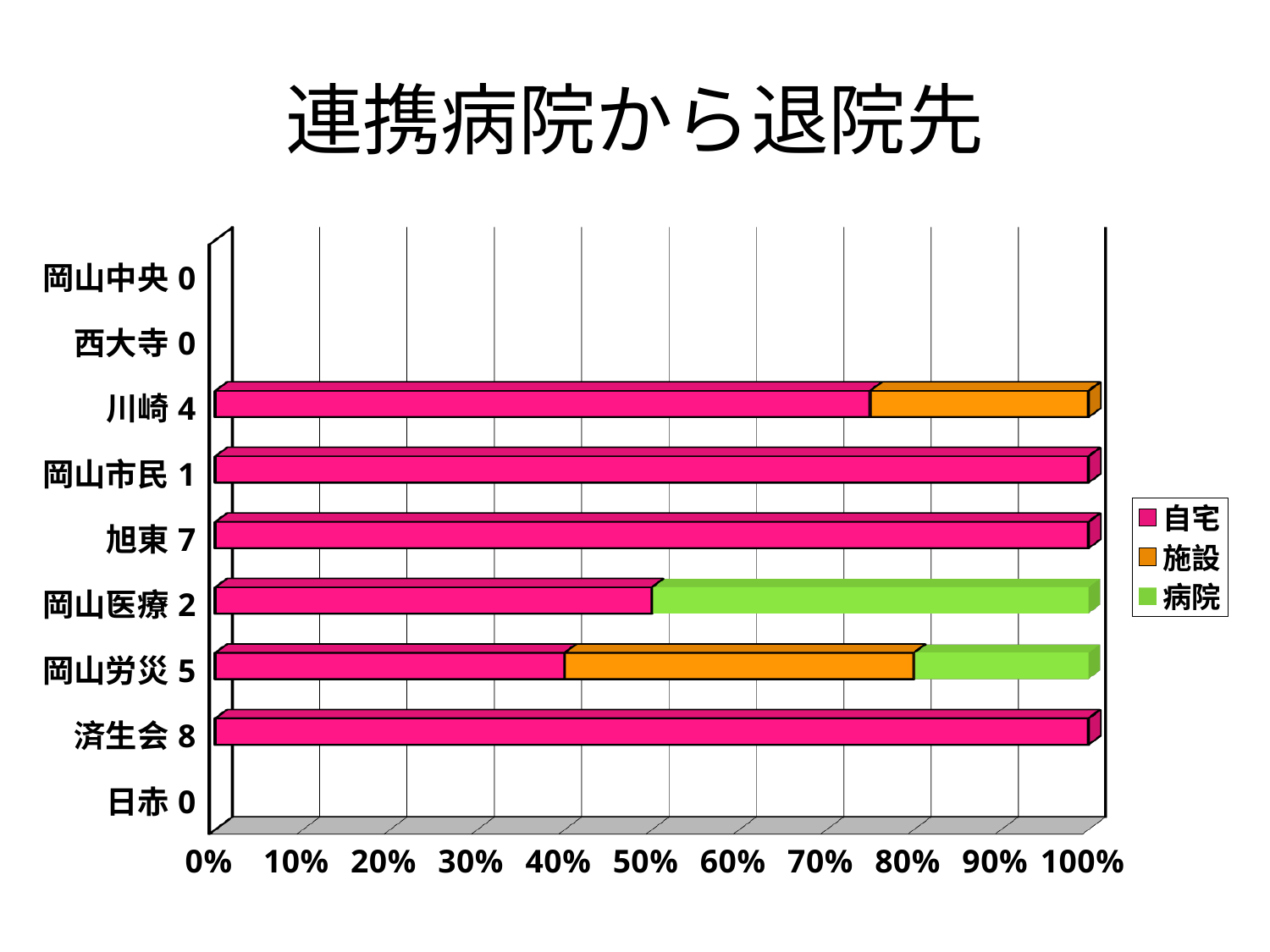
What is the 自宅 share for 岡山医療 2? 50% How many categories are shown on the vertical axis? 9 What kind of chart is shown on the slide? bar chart For 岡山労災 5, which is larger, the 施設 share or the 病院 share? 施設 What are the three entries in the legend? 自宅, 施設, 病院 Is the 自宅 share for 岡山労災 5 greater or less than 50%? less How many series does the legend list? 3 Which category has the largest 病院 share? 岡山医療 2 Is the 施設 share for 川崎 4 greater or less than 30%? less Is the 自宅 share for 川崎 4 greater or less than 70%? greater Which has the larger 自宅 share, 川崎 4 or 岡山医療 2? 川崎 4 Which categories have no bar plotted at all? 岡山中央 0, 西大寺 0, 日赤 0